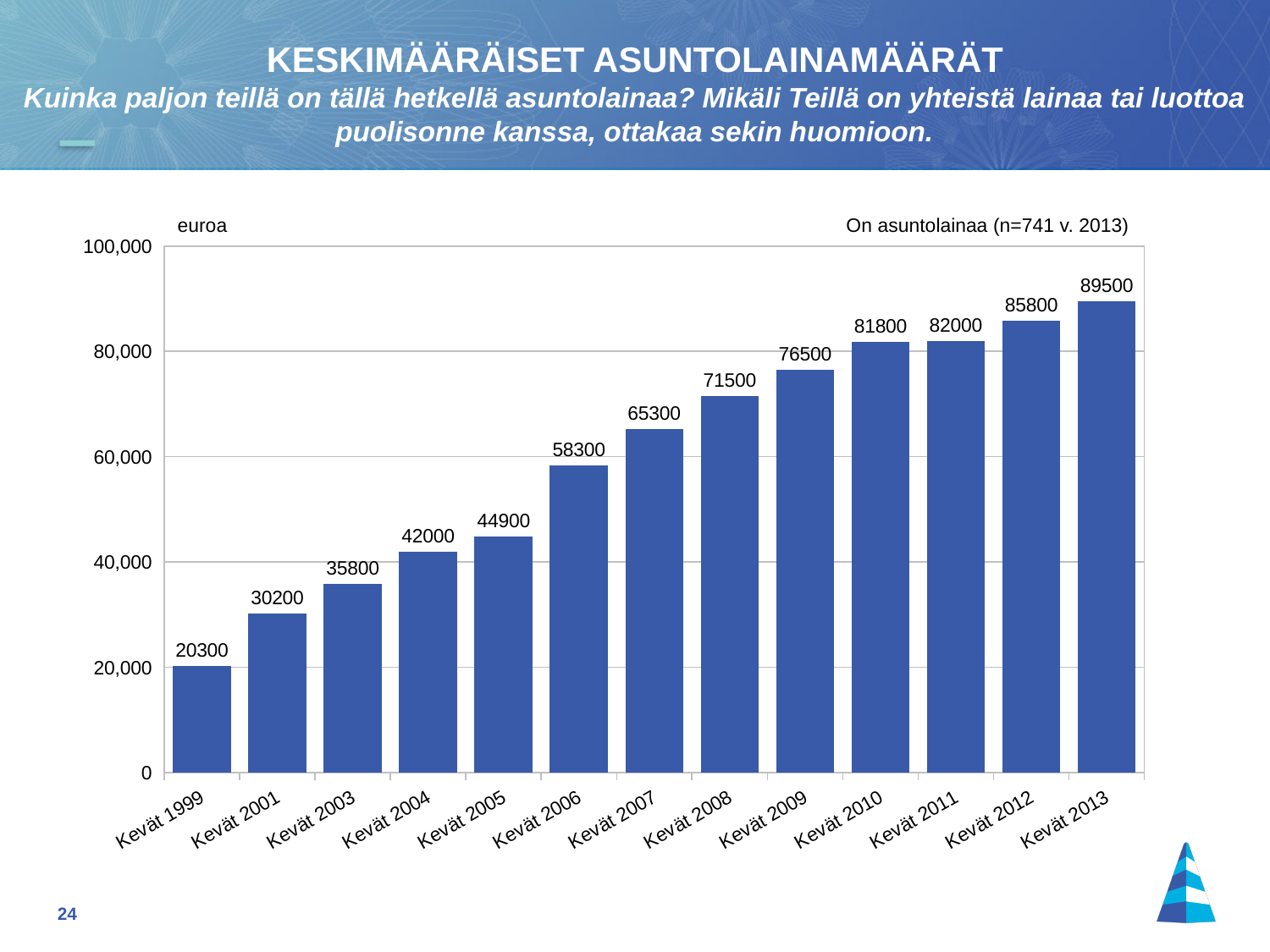
How many categories are shown on the x axis? 13 What is the value shown for Kevät 2011? 82000 What is the difference between the values for Kevät 2013 and Kevät 2012? 3700 Is the value for Kevät 2007 greater or less than 60,000? greater Which category has the highest value? Kevät 2013 What is the value shown for Kevät 1999? 20300 Which is larger, the value for Kevät 2004 or the value for Kevät 2005? Kevät 2005 What is the difference between the values for Kevät 2009 and Kevät 2008? 5000 Do the values rise or fall from Kevät 1999 to Kevät 2013? rise What kind of chart is shown on the slide? bar chart What is the average housing loan amount for Kevät 2006? 58300 Which category has the lowest value? Kevät 1999